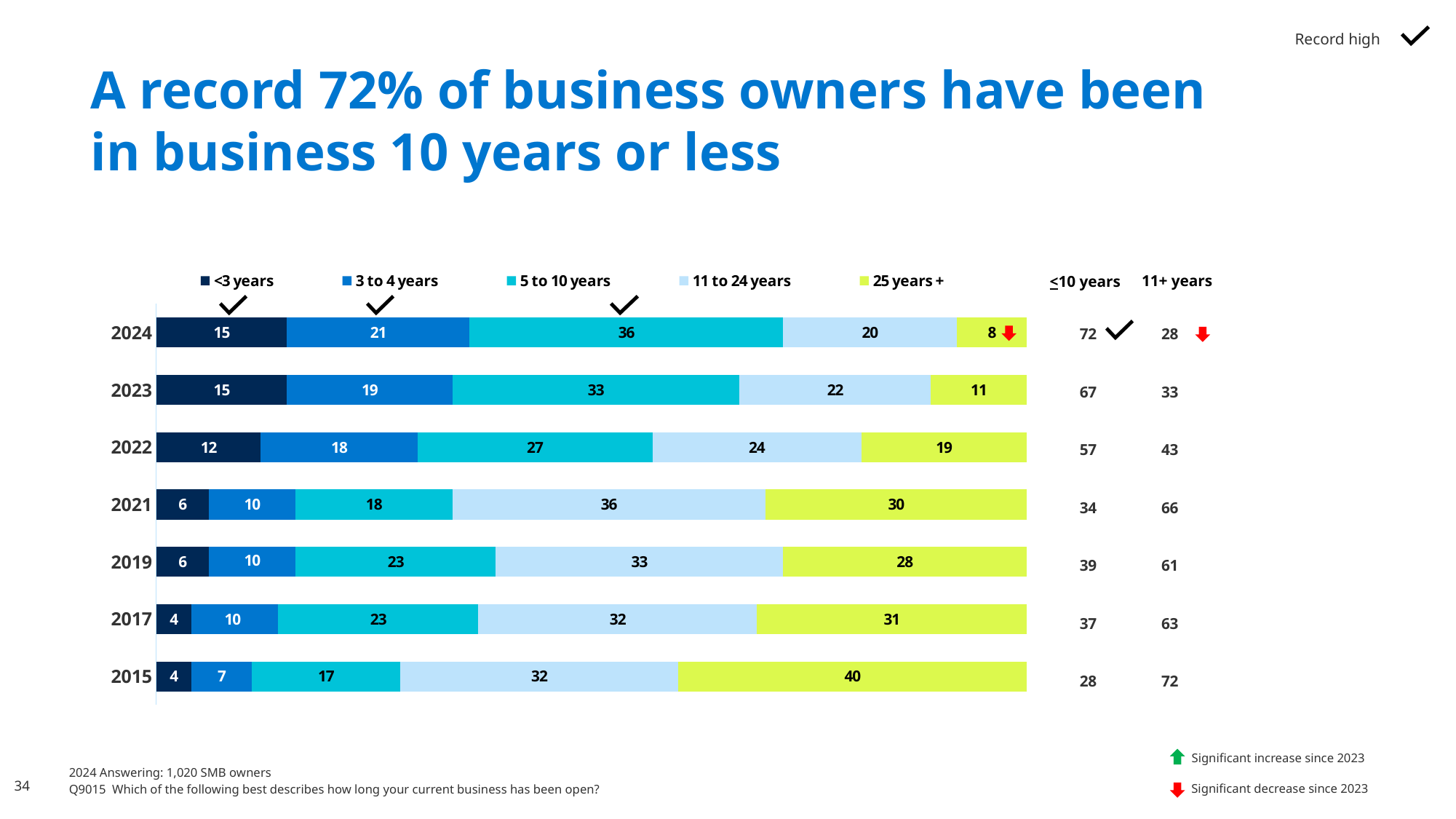
Which year has the highest value for '25 years +'? 2015 What kind of chart is shown on the slide? Stacked bar chart How many years (bars) are shown in the chart? 7 What is the difference between the '5 to 10 years' values for 2024 and 2023? 3 What is the value for '5 to 10 years' in 2024? 36 Is the '<3 years' value larger in 2022 or in 2021? 2022 Does the '25 years +' value rise or fall from 2015 to 2024? Fall How many series does the legend list? 5 Which year has the lowest value for '3 to 4 years'? 2015 What is the value for '11 to 24 years' in 2021? 36 What is the '≤10 years' total shown for 2024? 72 What is the value for '25 years +' in 2015? 40